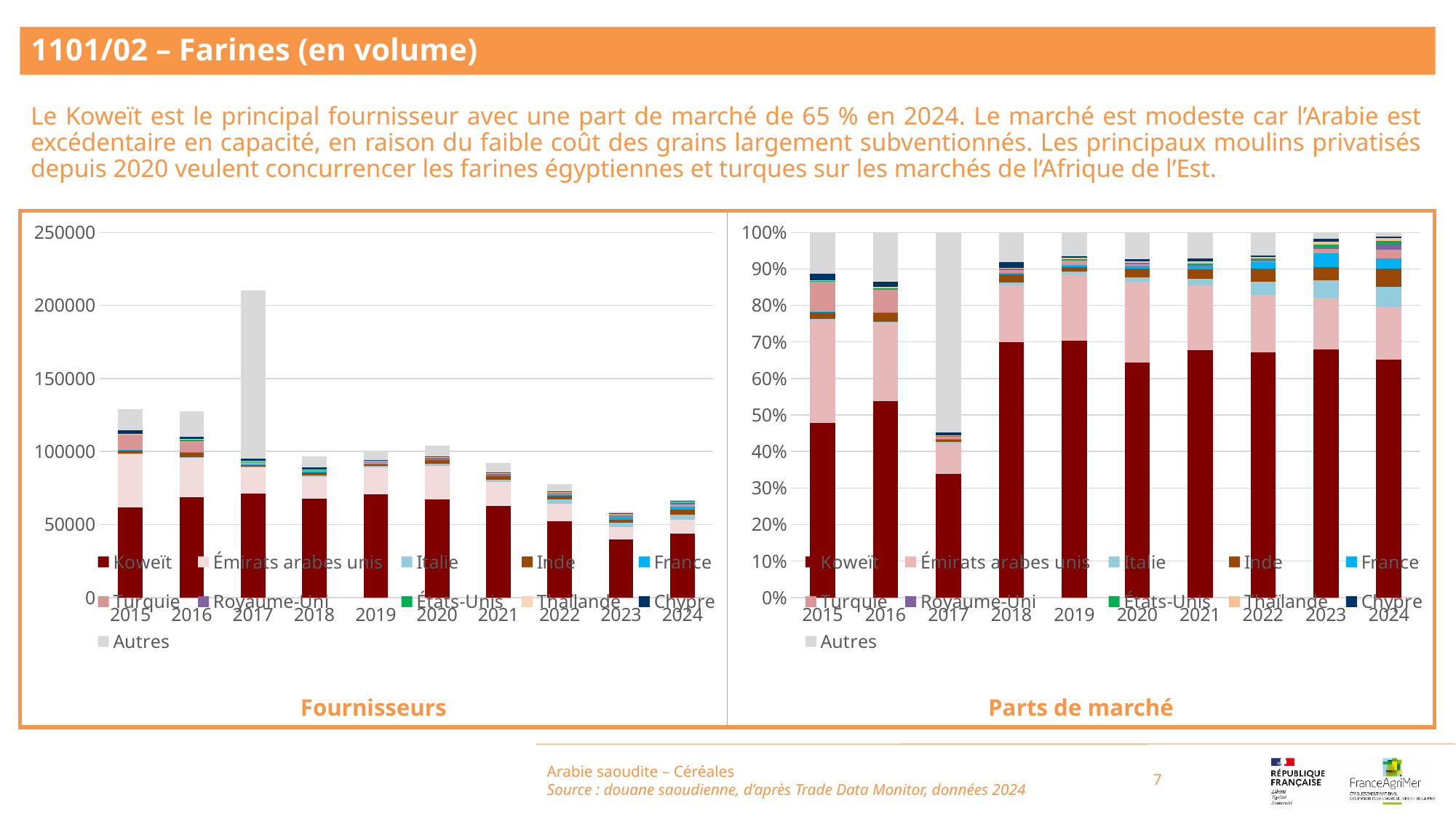
In the 'Parts de marché' chart, is the Koweït share for 2017 greater or less than 40%? less In the 'Fournisseurs' chart, is the total bar for 2023 greater or less than 100000? less In the 'Parts de marché' chart, is the Koweït share for 2024 greater or less than 60%? greater In the 'Parts de marché' chart, which year has the lowest Koweït share? 2017 What kind of chart is the 'Fournisseurs' chart on the left? Stacked bar chart Which series is shown in dark red in the legend of the 'Parts de marché' chart? Koweït How many years are shown on the x axis of the 'Parts de marché' chart? 10 In the 'Fournisseurs' chart, which year has the lowest total bar? 2023 How many series does the legend of the 'Fournisseurs' chart list? 11 In the 'Fournisseurs' chart, which year has the highest total bar? 2017